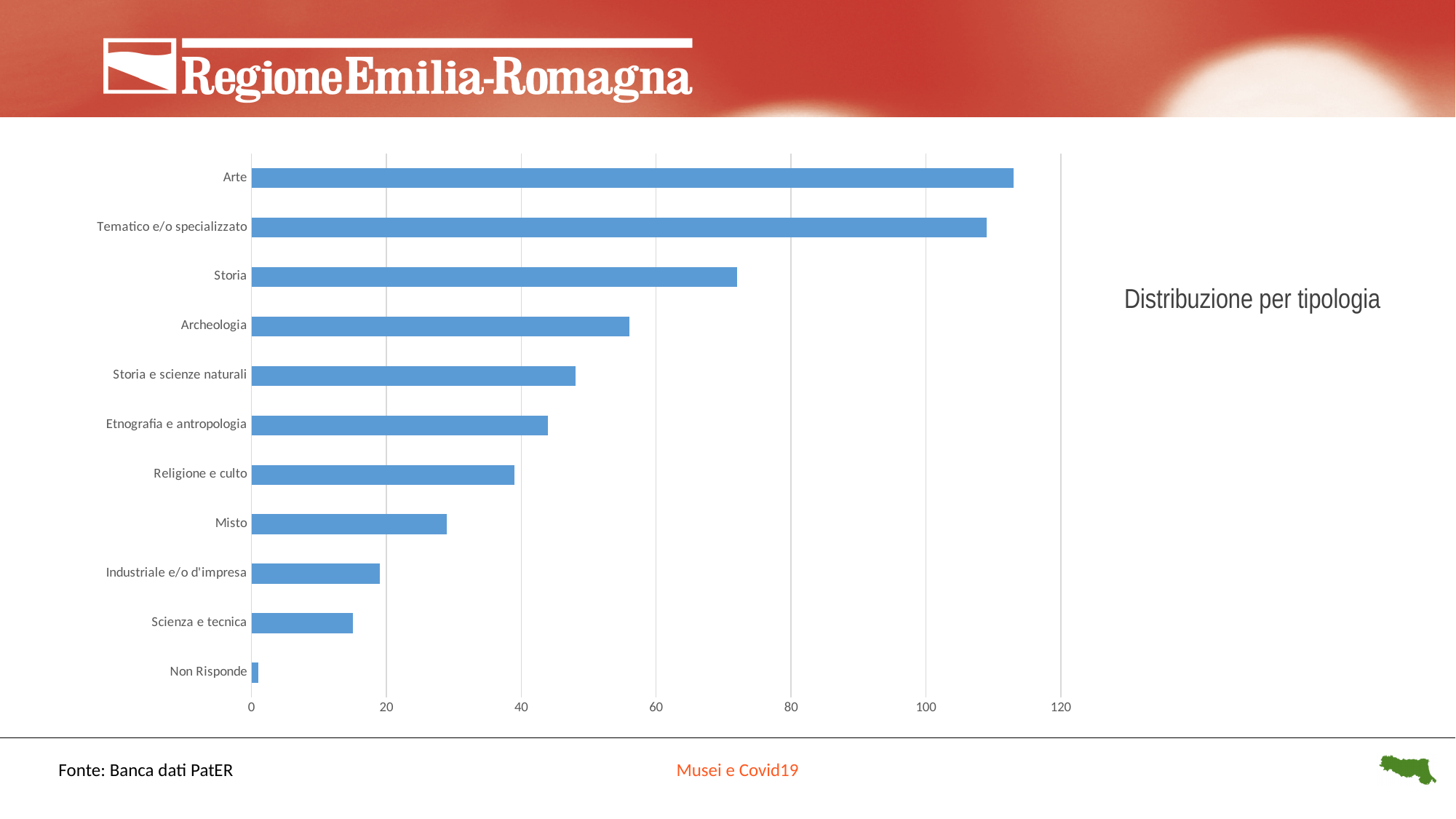
Is the value for Storia e scienze naturali greater or less than 40? greater Is the value for Storia greater or less than 60? greater Which category has the shortest bar in the chart? Non Risponde Is the value for Misto greater or less than 20? greater Which has the larger value, Storia or Archeologia? Storia Which category has the longest bar in the chart? Arte What is the title shown next to the chart? Distribuzione per tipologia Which has the larger value, Misto or Scienza e tecnica? Misto What kind of chart is shown on the slide? bar chart How many categories are plotted in the chart? 11